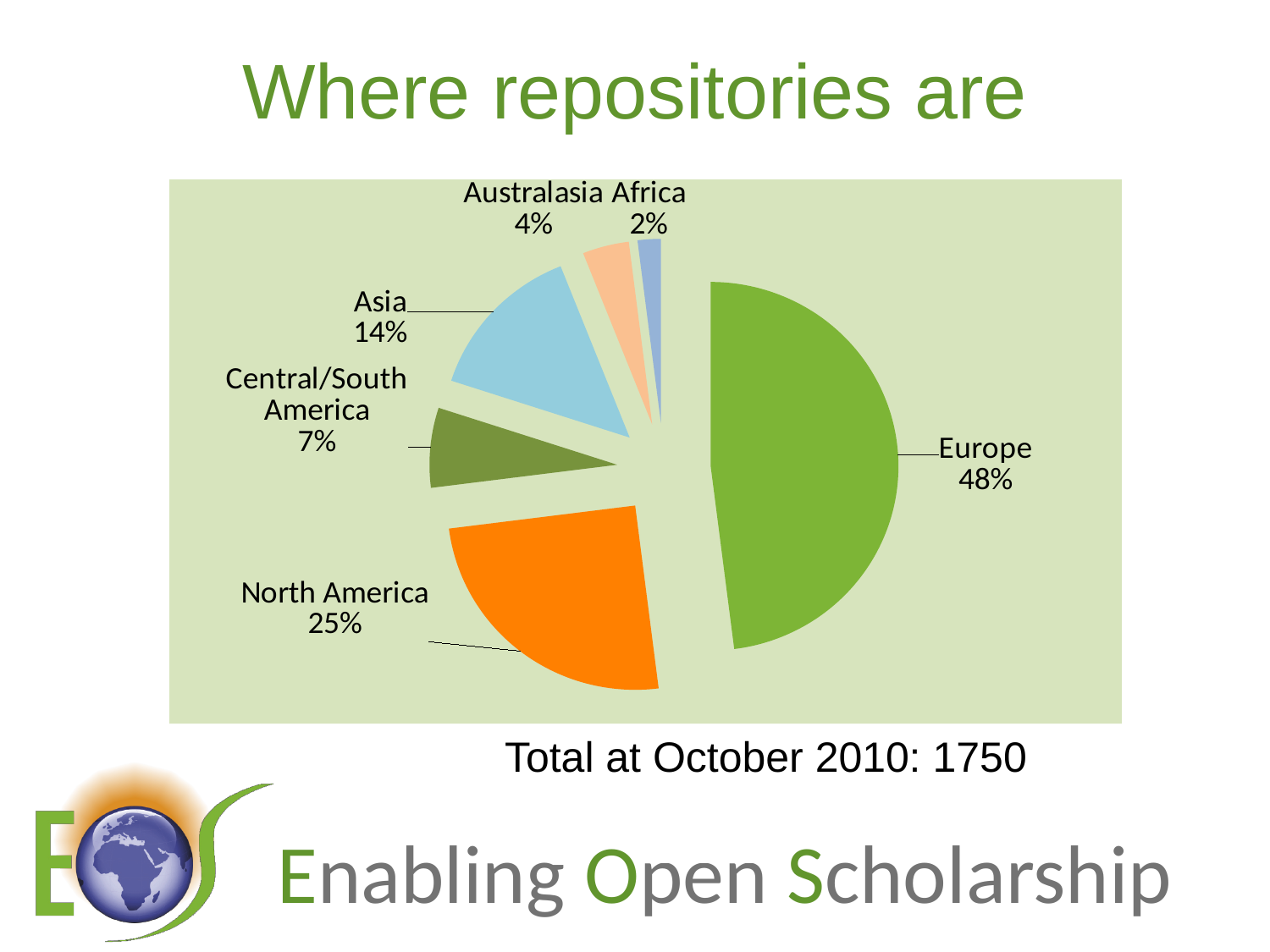
How many regions are shown in the pie chart? 6 What is the difference in percentage points between Europe's share and North America's share? 23 What share of repositories is in Australasia? 4% What share of repositories is in North America? 25% What share of repositories is in Europe? 48% Which region has the smallest share of repositories? Africa What share of repositories is in Asia? 14% What is the total number of repositories stated on the slide for October 2010? 1750 What kind of chart is shown on the slide? Pie chart Which has a larger share of repositories, Asia or Central/South America? Asia Which region has the largest share of repositories? Europe What share of repositories is in Central/South America? 7%